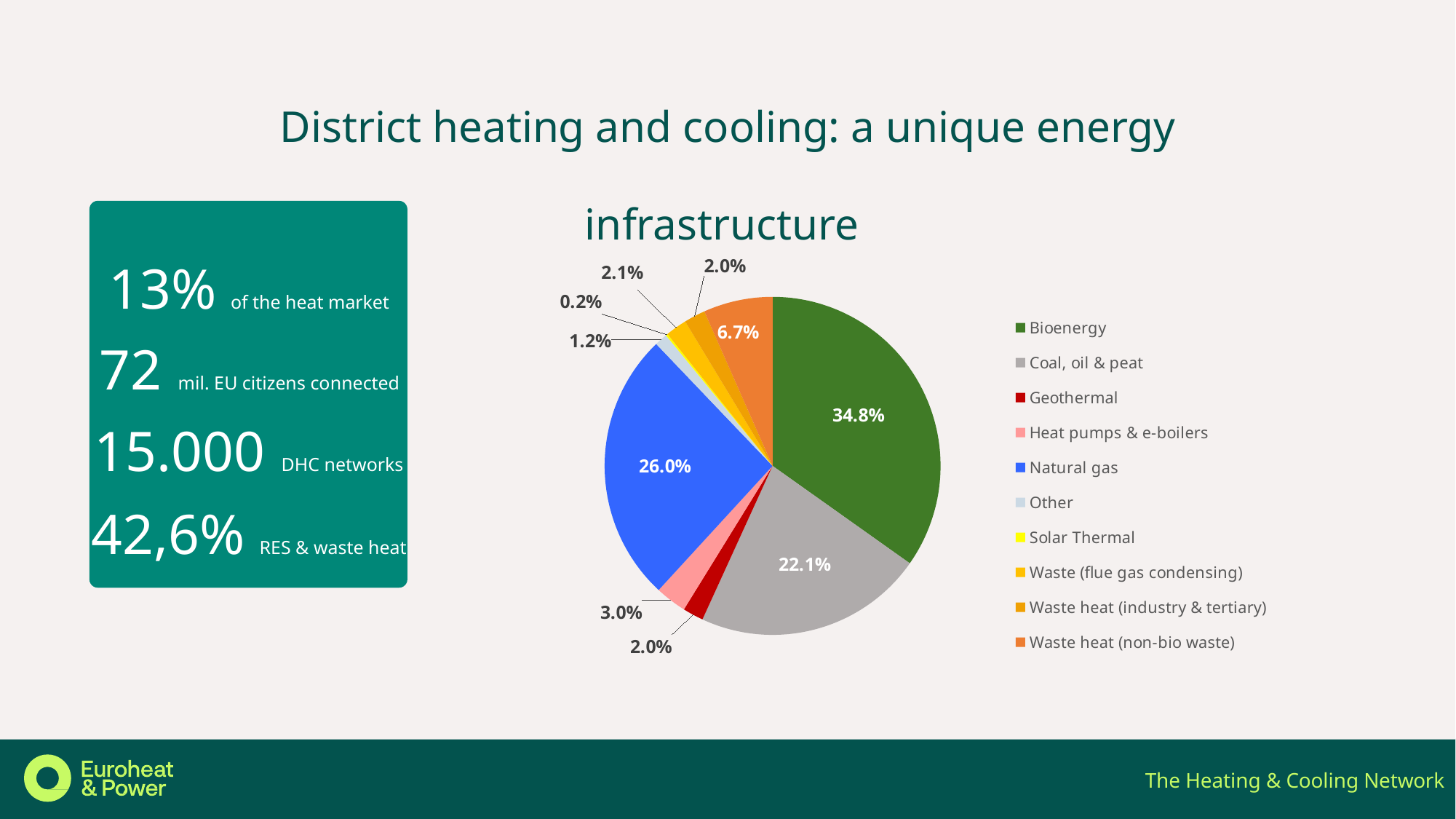
What is the value shown for Heat pumps & e-boilers? 3.0% What share of the pie does Bioenergy account for? 34.8% Which category has the largest share of the pie? Bioenergy How many categories does the legend list? 10 Which is larger, the share for Natural gas or the share for Coal, oil & peat? Natural gas What colour represents Natural gas in the pie chart? Blue What is the value shown for Natural gas? 26.0% What is the difference between the Bioenergy share and the Natural gas share? 8.8% What percentage is shown for Coal, oil & peat? 22.1% What is the value for Waste heat (non-bio waste)? 6.7% Which category has the smallest share of the pie? Solar Thermal What type of chart is shown on the slide? Pie chart